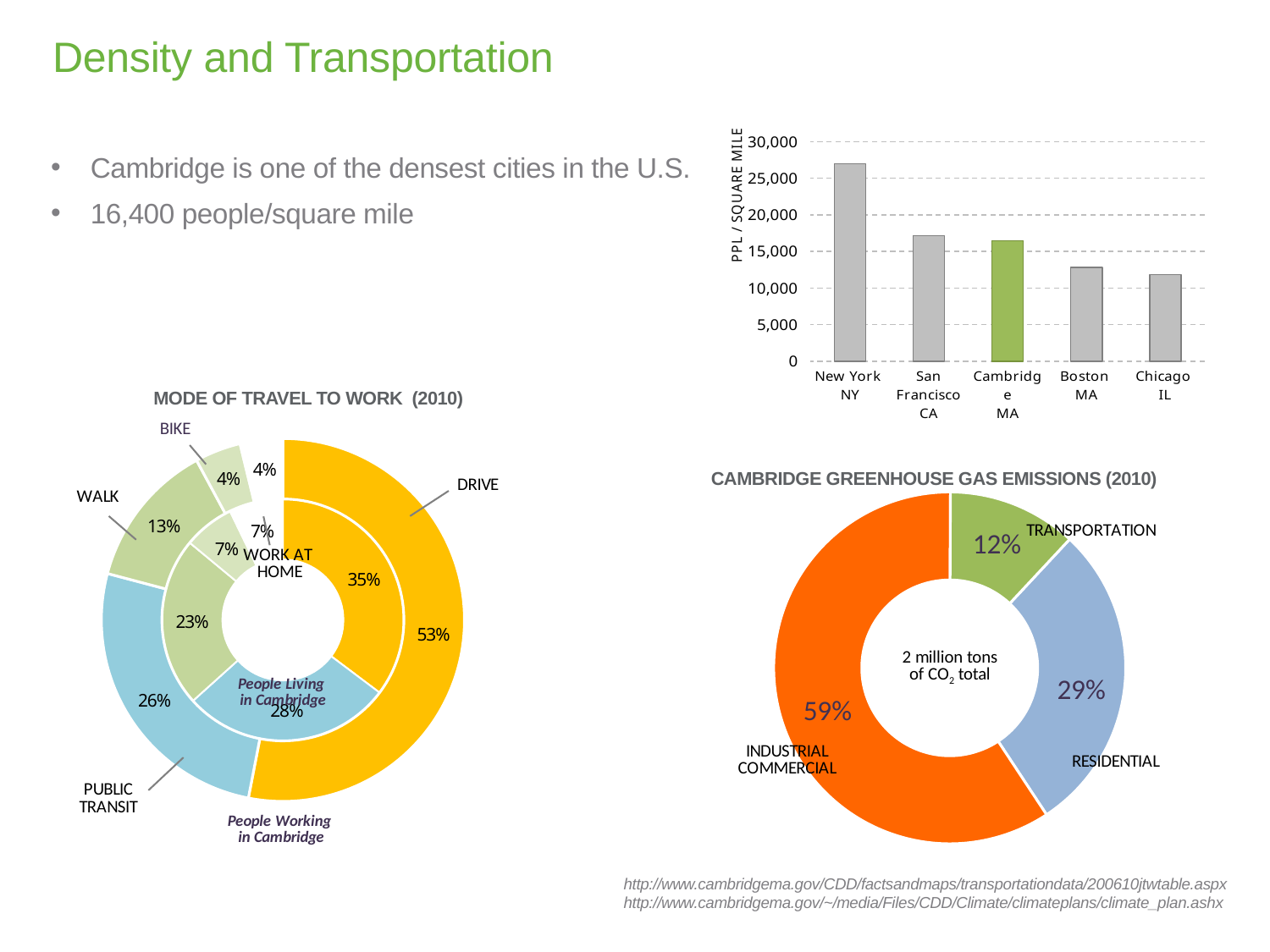
In the top-right bar chart of people per square mile, which city has the highest density? New York NY In the Cambridge Greenhouse Gas Emissions (2010) chart, what is the difference between the Industrial/Commercial and Residential shares? 30 percentage points In the Cambridge Greenhouse Gas Emissions (2010) chart, which category has the smallest share? Transportation In the Cambridge Greenhouse Gas Emissions (2010) chart, what total is stated in the center of the doughnut? 2 million tons of CO2 total In the Mode of Travel to Work (2010) chart, what percentage of people working in Cambridge (outer ring) use public transit? 26% What kind of chart is the top-right chart showing people per square mile? Bar chart In the top-right bar chart of people per square mile, which is larger, San Francisco CA or Boston MA? San Francisco CA In the Mode of Travel to Work (2010) chart, what percentage of people working in Cambridge (outer ring) drive? 53% In the Cambridge Greenhouse Gas Emissions (2010) chart, what share is Industrial/Commercial? 59% In the top-right bar chart of people per square mile, is the value for Boston MA greater or less than 15,000? less In the top-right bar chart of people per square mile, how many cities are shown? 5 In the top-right bar chart of people per square mile, is the value for New York NY greater or less than 25,000? greater